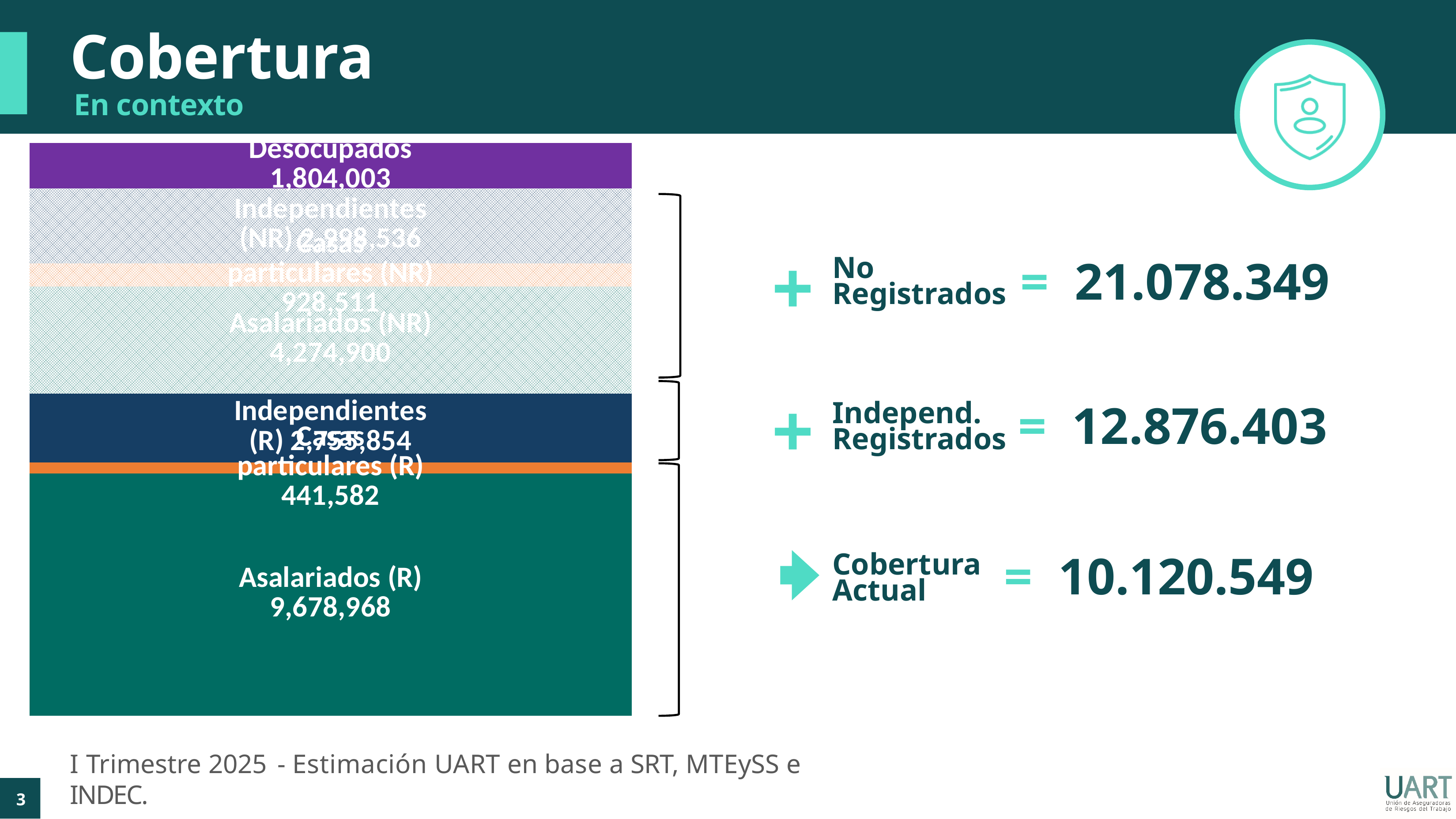
What value is shown for the Asalariados (NR) segment? 4,274,900 Which segment of the stacked bar has the smallest value? Casas particulares (R) How many segments make up the stacked bar? 7 What value is shown for the Asalariados (R) segment of the stacked bar? 9,678,968 What kind of chart is shown on the slide? Stacked bar chart What value is shown for the Desocupados segment of the stacked bar? 1,804,003 What is the difference between the Asalariados (R) and Asalariados (NR) values? 5,404,068 Which segment of the stacked bar has the largest value? Asalariados (R) What is the difference between the Desocupados and Casas particulares (NR) values? 875,492 Which is larger, Desocupados or Asalariados (NR)? Asalariados (NR) What value is shown for the Casas particulares (R) segment? 441,582 What value is shown for the Casas particulares (NR) segment? 928,511